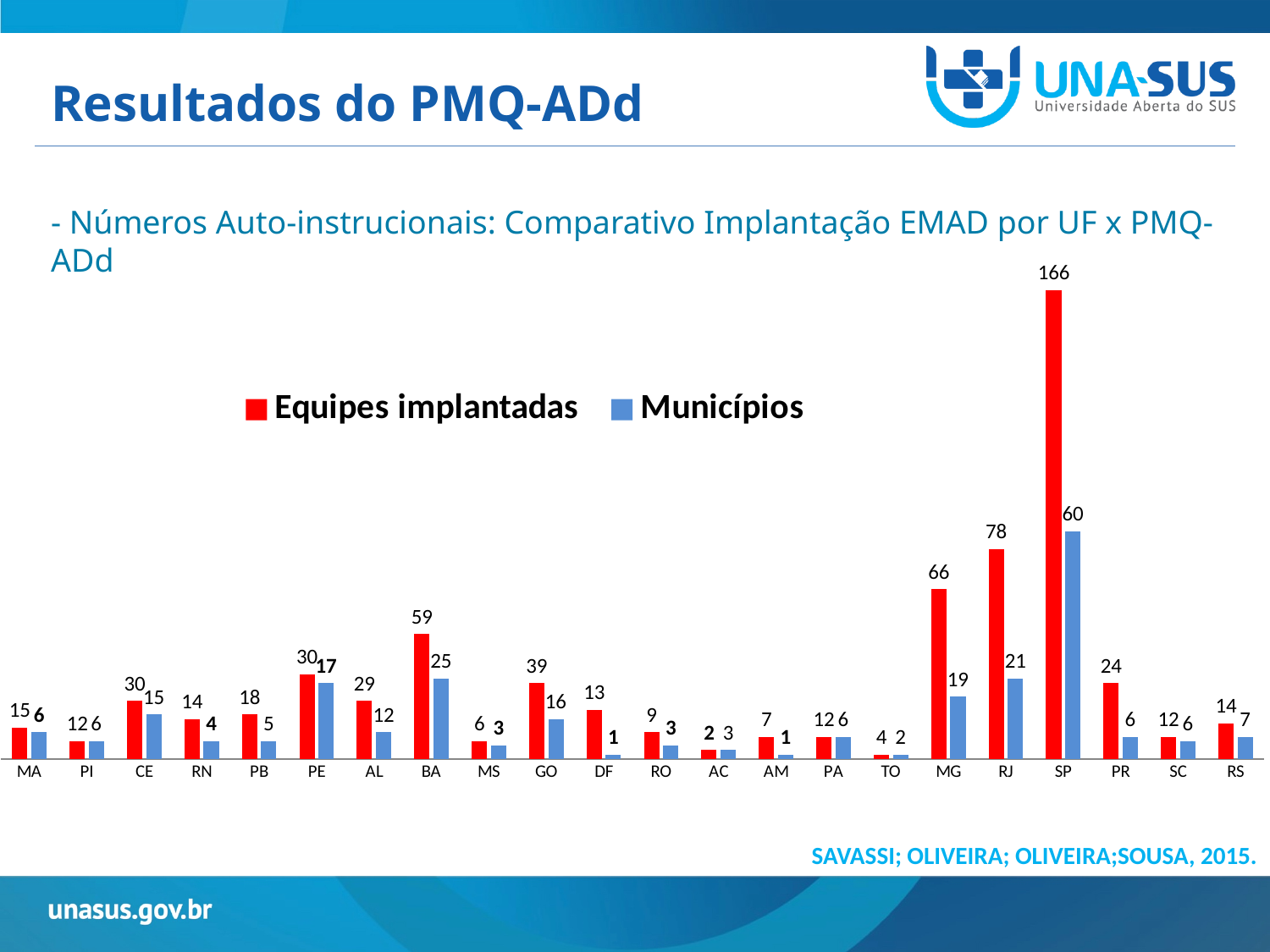
What is the value of Equipes implantadas for SP? 166 Which UF has more Equipes implantadas, BA or MG? MG Which is larger for MG: Equipes implantadas or Municípios? Equipes implantadas How many series does the legend list? 2 Which UF has the lowest value for Equipes implantadas? AC How many UFs (categories) are shown on the x axis? 22 Which UF has the highest value for Equipes implantadas? SP Which colour represents the Municípios series? Blue What is the difference between Equipes implantadas and Municípios for RJ? 57 What kind of chart is shown on the slide? Bar chart What is the value of Equipes implantadas for GO? 39 What is the value of Municípios for BA? 25